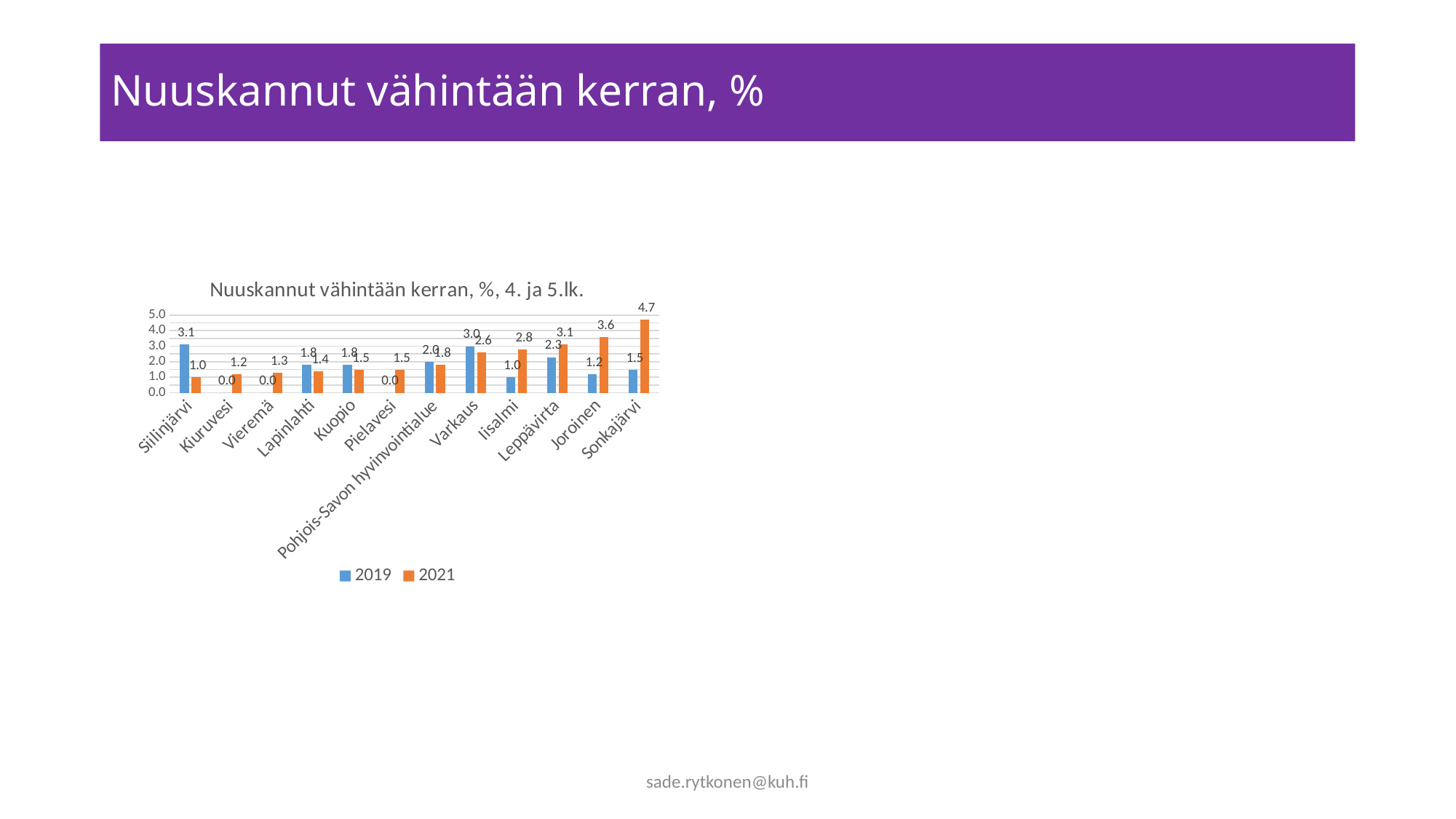
What is the 2021 value for Joroinen? 3.6 What is the title of the chart? Nuuskannut vähintään kerran, %, 4. ja 5.lk. What is the 2021 value for Sonkajärvi? 4.7 Which is larger for Iisalmi, the 2019 value or the 2021 value? 2021 What kind of chart is shown? Bar chart What is the difference between the 2021 and 2019 values for Sonkajärvi? 3.2 How many series does the legend list? 2 Which category has the highest 2021 value? Sonkajärvi What is the 2019 value for Siilinjärvi? 3.1 How many categories are shown on the x axis? 12 What is the 2019 value for Pohjois-Savon hyvinvointialue? 2.0 Which category has the lowest 2021 value? Siilinjärvi